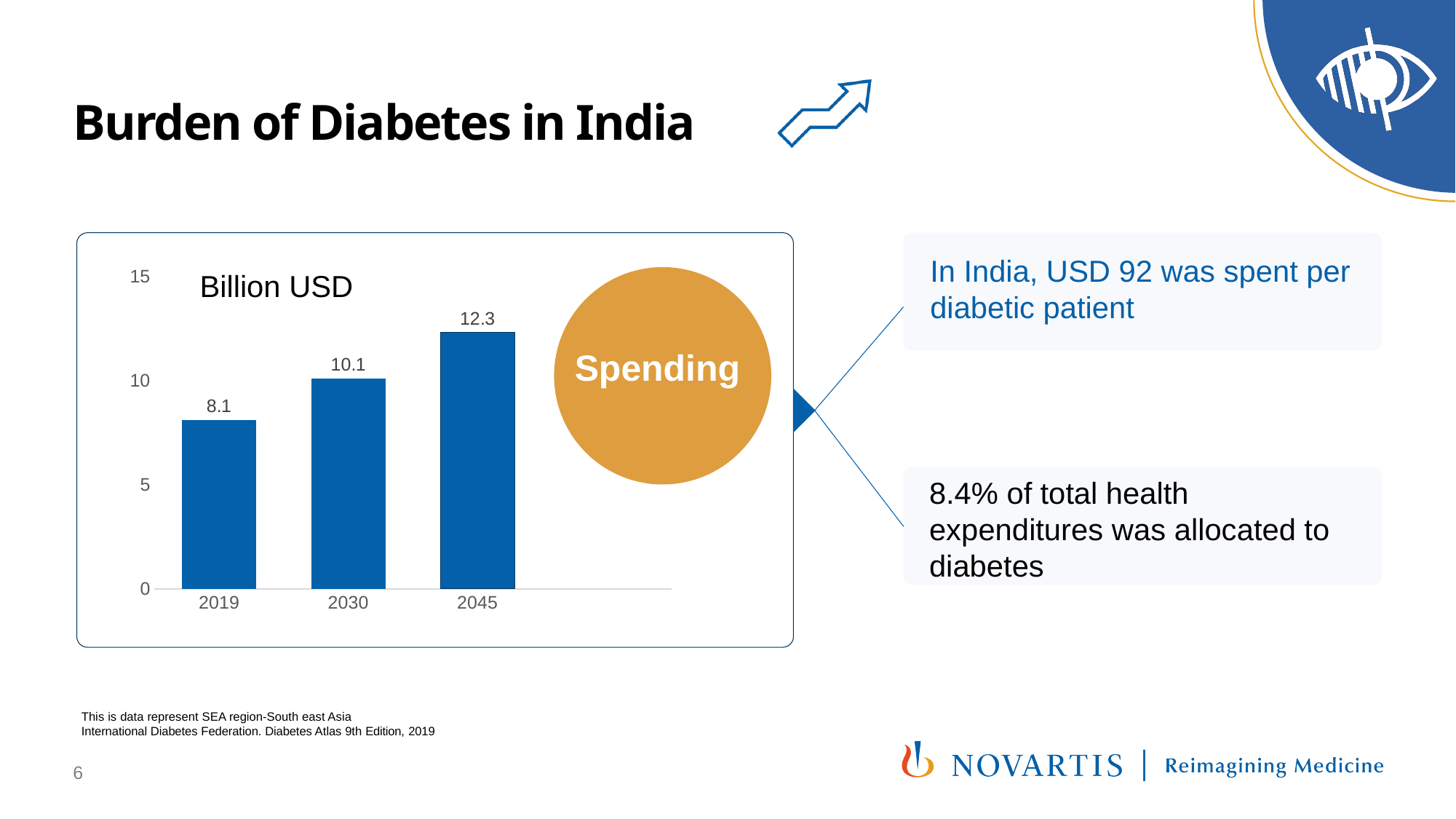
Which is larger, the value for 2030 or the value for 2045? 2045 How many bars are shown in the chart? 3 What kind of chart is shown on the slide? bar chart Which year has the highest value? 2045 What is the difference between the values for 2030 and 2019? 2.0 Do the values rise or fall from 2019 to 2045? rise Is the value for 2019 greater or less than 10? less What is the value for 2030? 10.1 What is the difference between the values for 2045 and 2019? 4.2 Which year has the lowest value? 2019 What is the value for 2045? 12.3 What is the value for 2019? 8.1